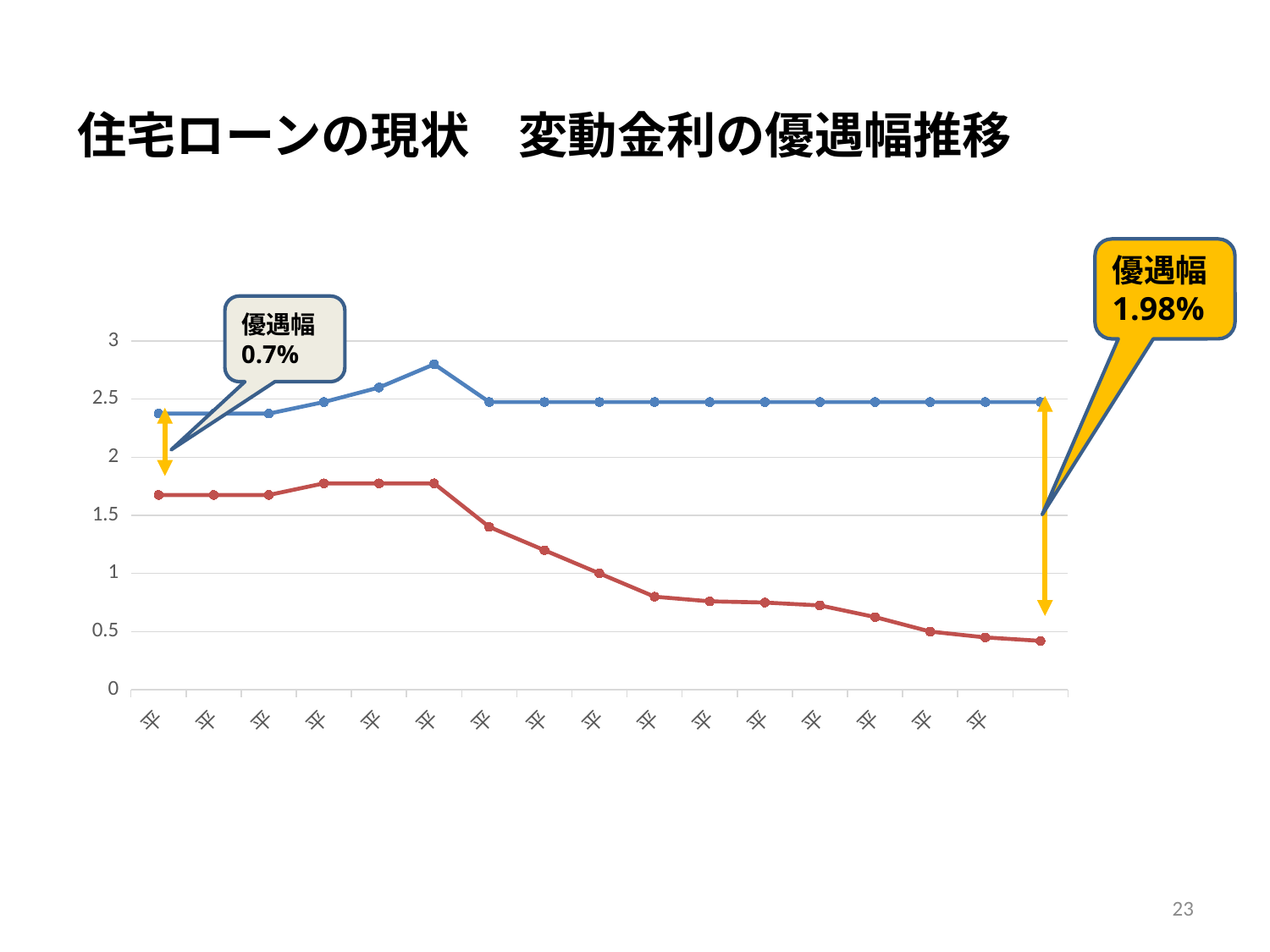
At the right end of the chart, which line is higher, the blue line or the red line? the blue line What 優遇幅 value is shown in the callout at the left side of the chart? 0.7% What kind of chart is shown on the slide? line chart Is the value of the red line at the left end of the chart greater or less than 1.5? greater Is the value of the red line at the right end of the chart greater or less than 1? less Does the red line generally rise or fall from left to right across the chart? fall What is the title of the slide containing the chart? 住宅ローンの現状 変動金利の優遇幅推移 How many lines (series) are plotted in the chart? 2 What 優遇幅 value is shown in the callout at the right side of the chart? 1.98% Is the highest point of the blue line greater or less than 2.5? greater What is the highest value shown on the vertical axis? 3